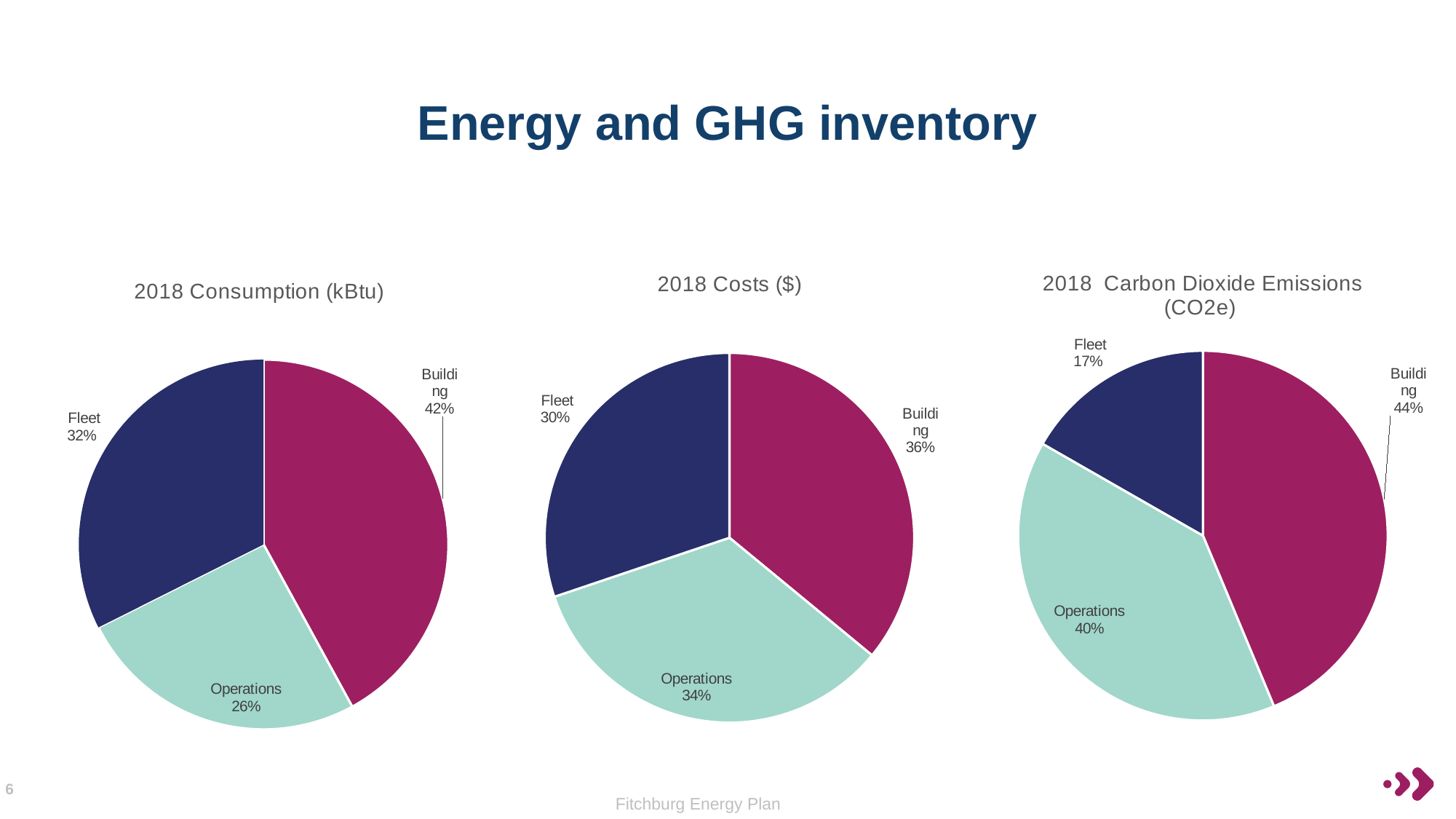
In the 2018 Costs ($) chart, what is the difference between the Building and Fleet shares? 6% How many charts are shown on the slide? 3 In the 2018 Consumption (kBtu) chart, what is the value for Operations? 26% In the 2018 Carbon Dioxide Emissions (CO2e) chart, what is the difference between Building and Operations? 4% In the 2018 Consumption (kBtu) chart, what share does Building have? 42% In the 2018 Carbon Dioxide Emissions (CO2e) chart, which is larger, Operations or Fleet? Operations In the 2018 Consumption (kBtu) chart, which category has the smallest share? Operations In the 2018 Carbon Dioxide Emissions (CO2e) chart, what share does Fleet have? 17% In the 2018 Costs ($) chart, what is the value for Fleet? 30% How many categories does the 2018 Consumption (kBtu) chart show? 3 What kind of chart is the 2018 Costs ($) chart? Pie chart In the 2018 Costs ($) chart, which category has the largest share? Building